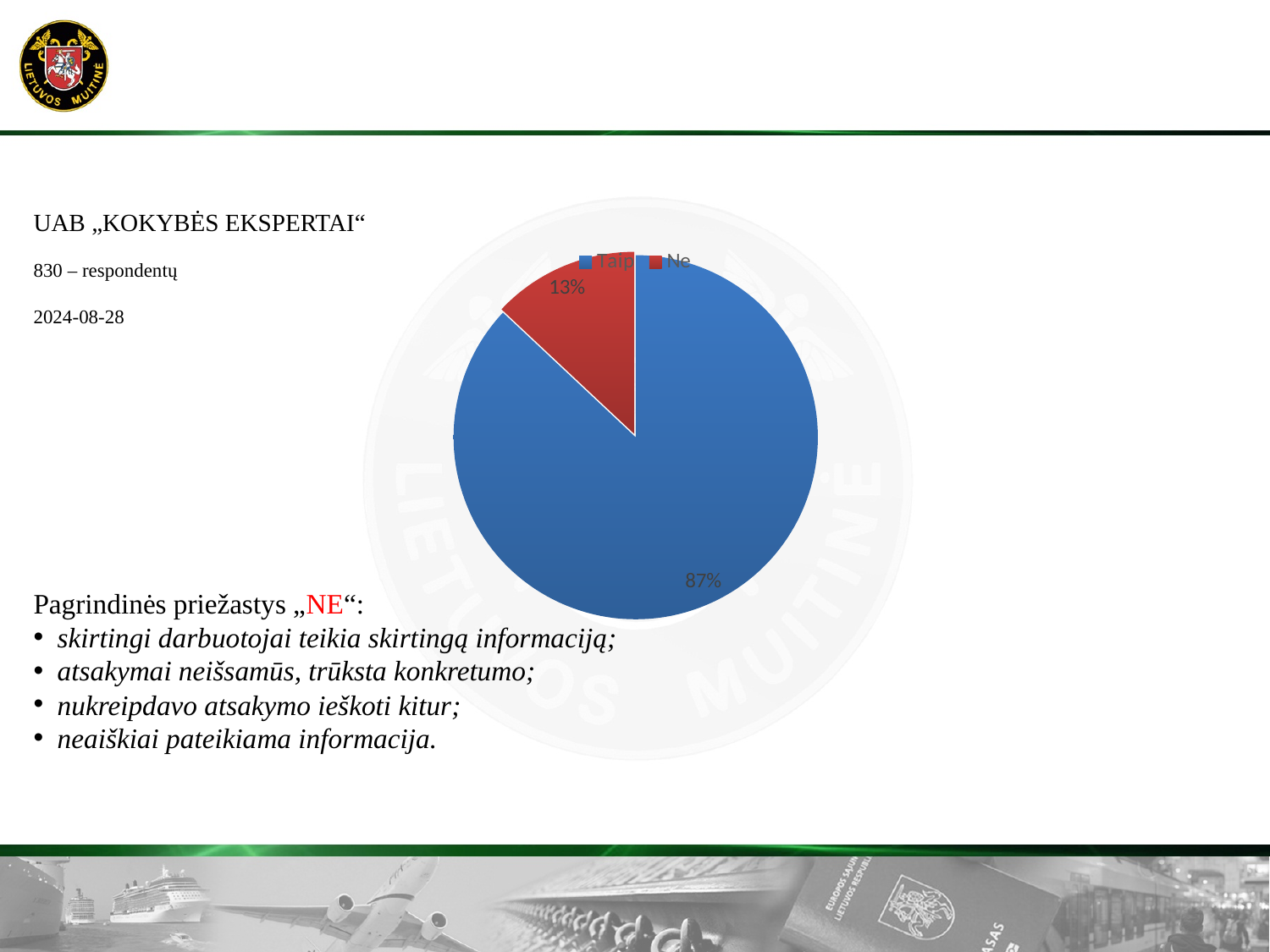
How many entries does the chart legend list? 2 What is the difference in percentage points between the "Taip" and "Ne" slices? 74 What colour is the "Taip" slice in the pie chart? blue What kind of chart is shown on the slide? pie chart What colour is the "Ne" slice in the pie chart? red How many slices does the pie chart have? 2 What share of the pie does the "Taip" slice represent? 87% Which slice of the pie chart is the smallest? Ne Which slice of the pie chart is the largest? Taip What share of the pie does the "Ne" slice represent? 13% Which is larger, the "Taip" slice or the "Ne" slice? Taip